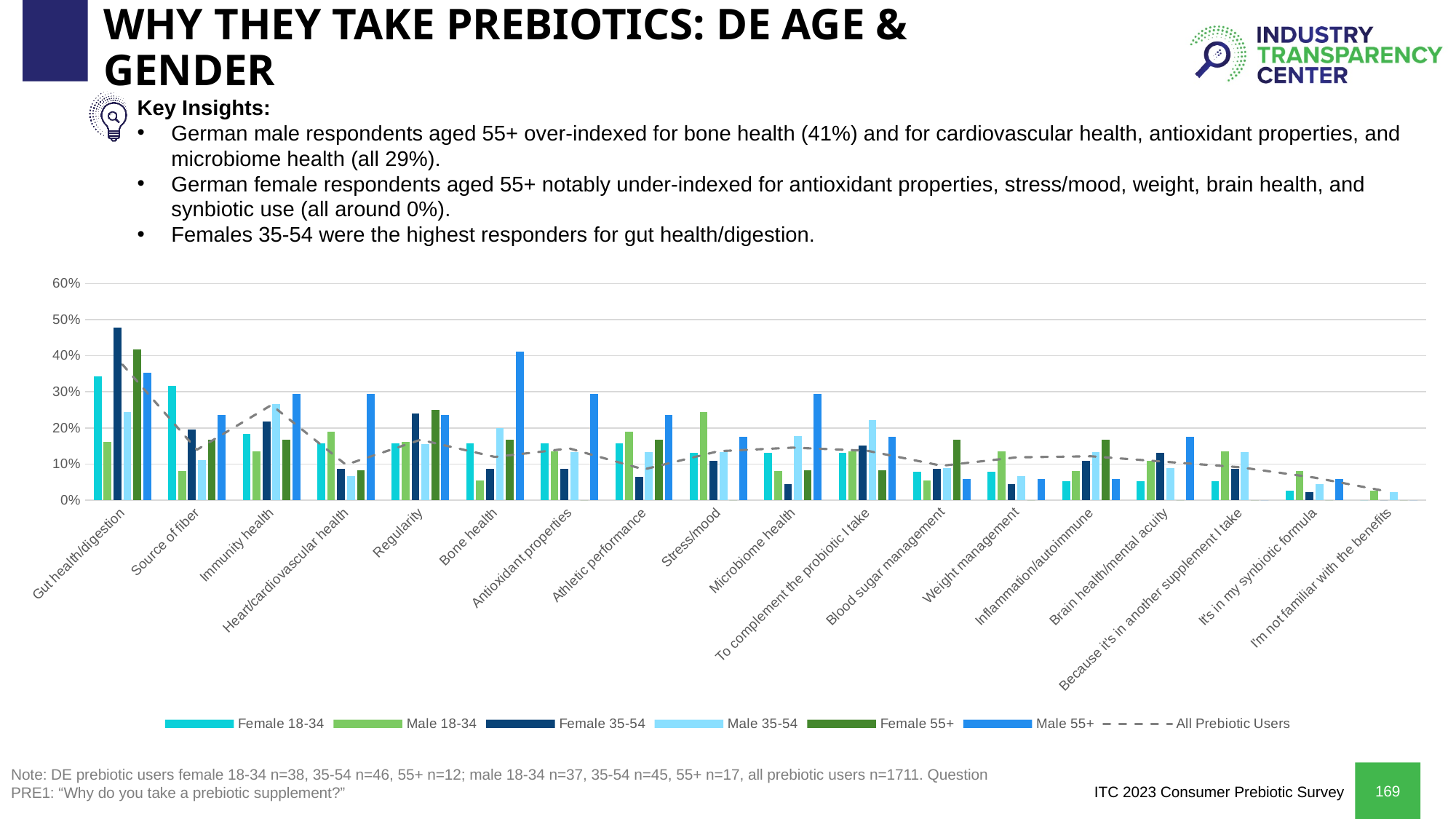
Which category has the highest Female 35-54 bar? Gut health/digestion What kind of chart is shown on the slide? Bar chart (with a dashed line series) Is the Female 55+ value for Antioxidant properties greater or less than 10%? less Is the Male 55+ value for Bone health greater or less than 30%? greater Which category has the highest Male 55+ bar? Bone health Is the Male 55+ value for Antioxidant properties greater or less than 20%? greater For Bone health, which is larger: the Male 55+ bar or the Female 35-54 bar? Male 55+ Does the dashed All Prebiotic Users line generally rise or fall from left to right across the categories? Fall How many series does the chart legend list? 7 Which series in the legend is drawn as a dashed line rather than bars? All Prebiotic Users How many categories are shown along the x axis of the chart? 18